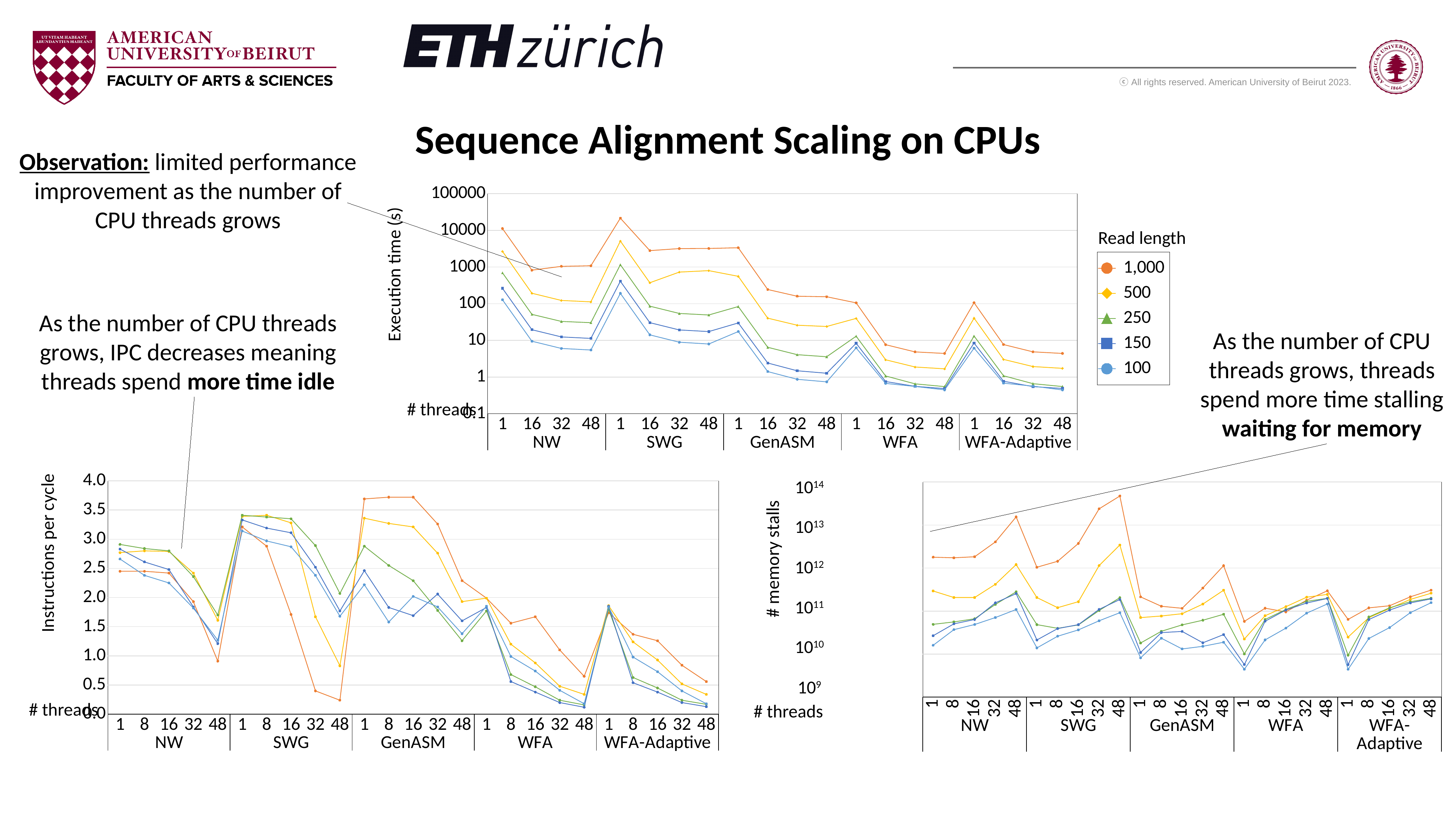
What kind of chart is the top chart showing execution time? line chart In the top execution time chart, does the execution time for SWG with read length 1,000 rise or fall from 1 thread to 16 threads? fall How many algorithm groups are shown along the x axis of the top execution time chart? 5 In the top execution time chart, is the value for NW at 1 thread with read length 1,000 greater or less than 1000? greater In the top execution time chart, is the value for WFA at 48 threads with read length 1,000 greater or less than 10? less How many series does the Read length legend list? 5 In the top execution time chart, which read length has the larger execution time for NW at 1 thread: 1,000 or 100? 1,000 In the bottom-left Instructions per cycle chart, is the value for SWG at 48 threads with read length 1,000 greater or less than 0.5? less In the bottom-left Instructions per cycle chart, does the IPC for NW with read length 1,000 rise or fall as the number of threads increases from 1 to 48? fall What is the y-axis label of the bottom-right chart? # memory stalls